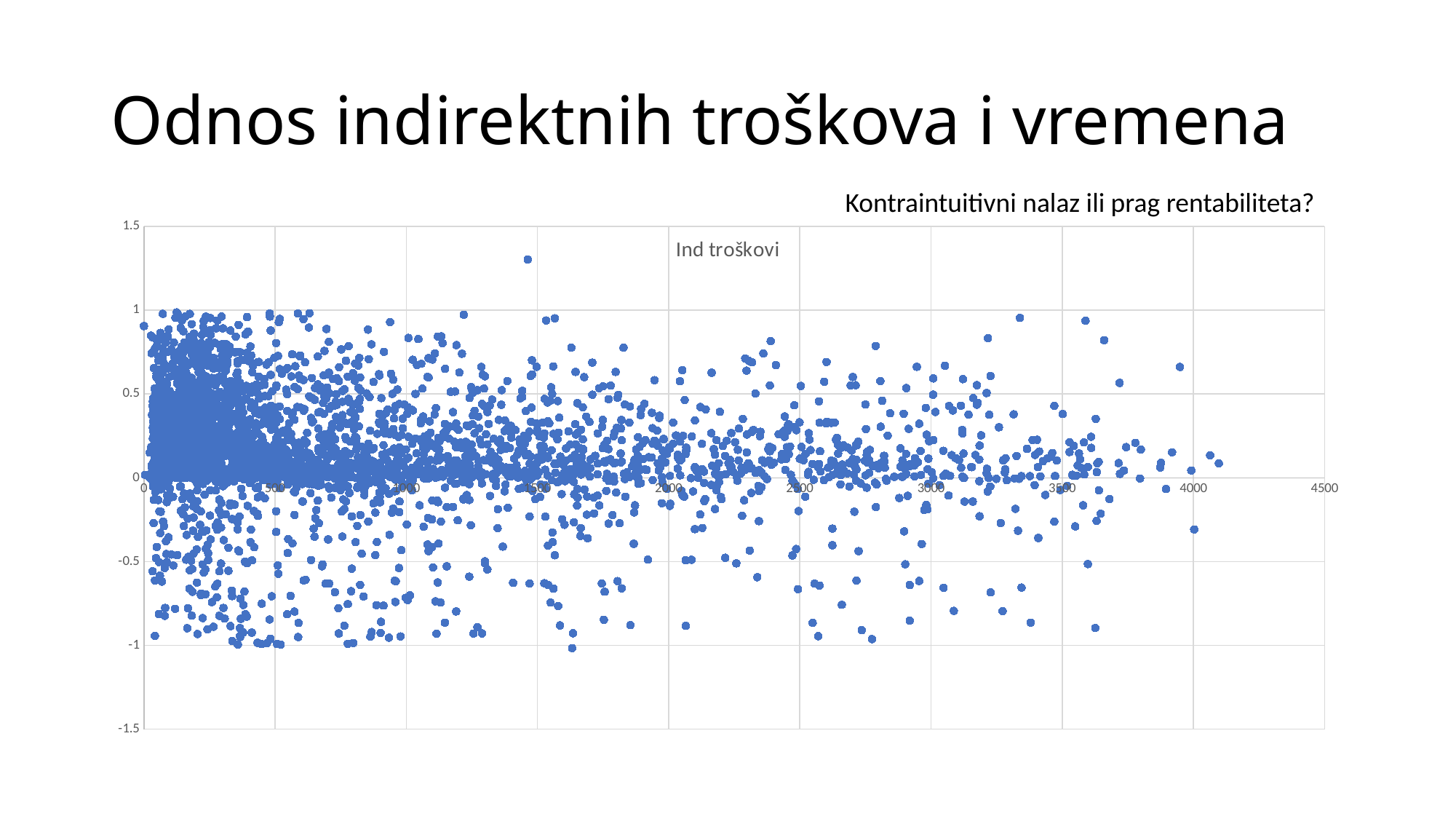
Is the lowest plotted point in the chart greater or less than -1.5 on the y axis? greater What kind of chart is shown on the slide? scatter chart Is the highest plotted point in the chart greater or less than 1 on the y axis? greater What is the largest value shown on the x axis of the chart? 4500 Is the x-axis position of the highest plotted point greater or less than 2000? less What is the title of the chart? Ind troškovi